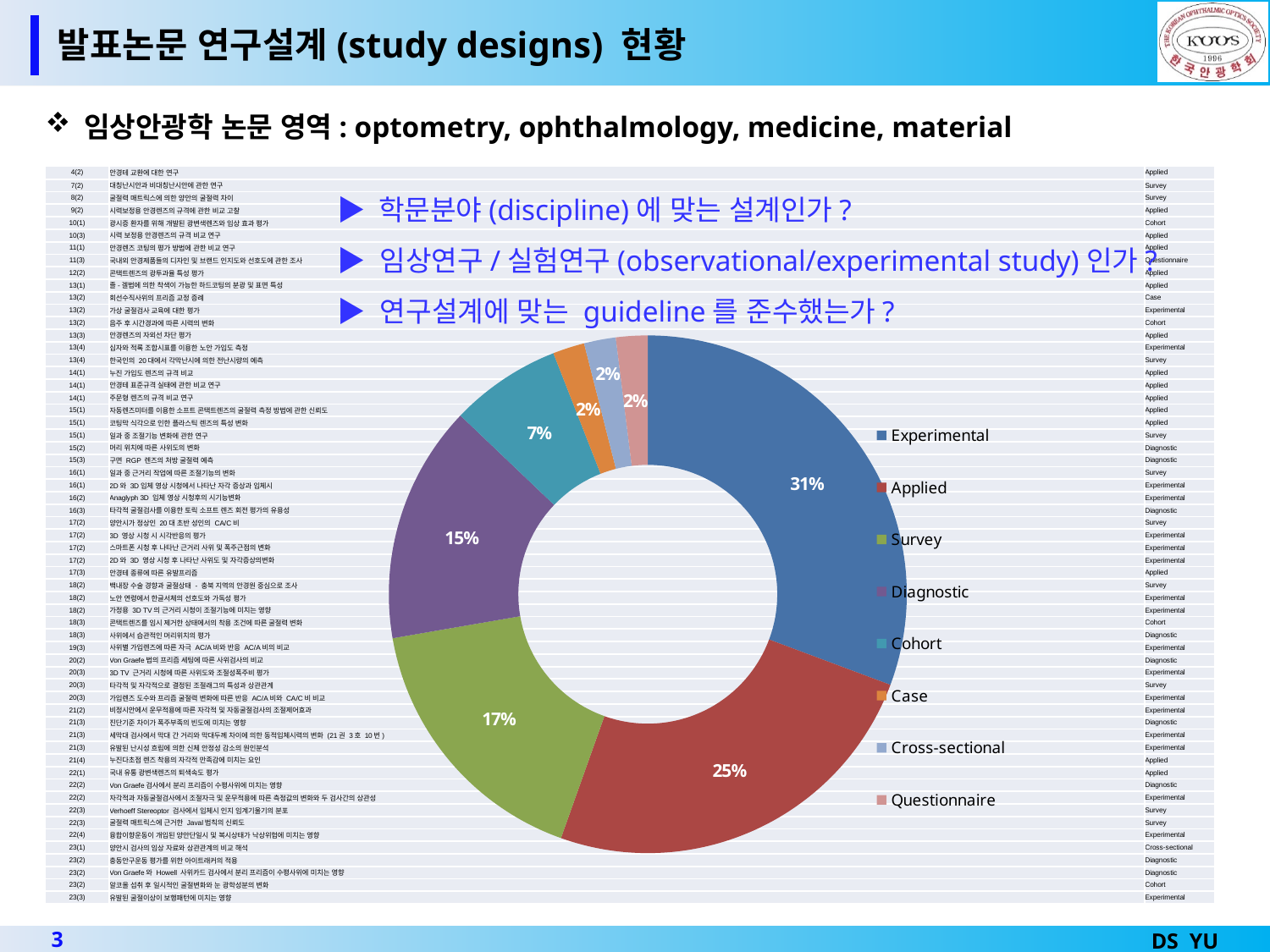
Which category has the largest share of the doughnut chart? Experimental How many categories does the legend of the doughnut chart list? 8 Which legend entry is shown in red in the doughnut chart? Applied What percentage of the doughnut chart is Diagnostic? 15% What percentage of the doughnut chart is Applied? 25% Which is larger in the doughnut chart, Survey or Diagnostic? Survey What is the difference in percentage points between Experimental and Applied? 6 What percentage of the doughnut chart is Experimental? 31% What is the combined share of Experimental and Applied in the doughnut chart? 56% What percentage of the doughnut chart is Cohort? 7% What percentage of the doughnut chart is Survey? 17% What kind of chart is shown on the slide? Doughnut chart